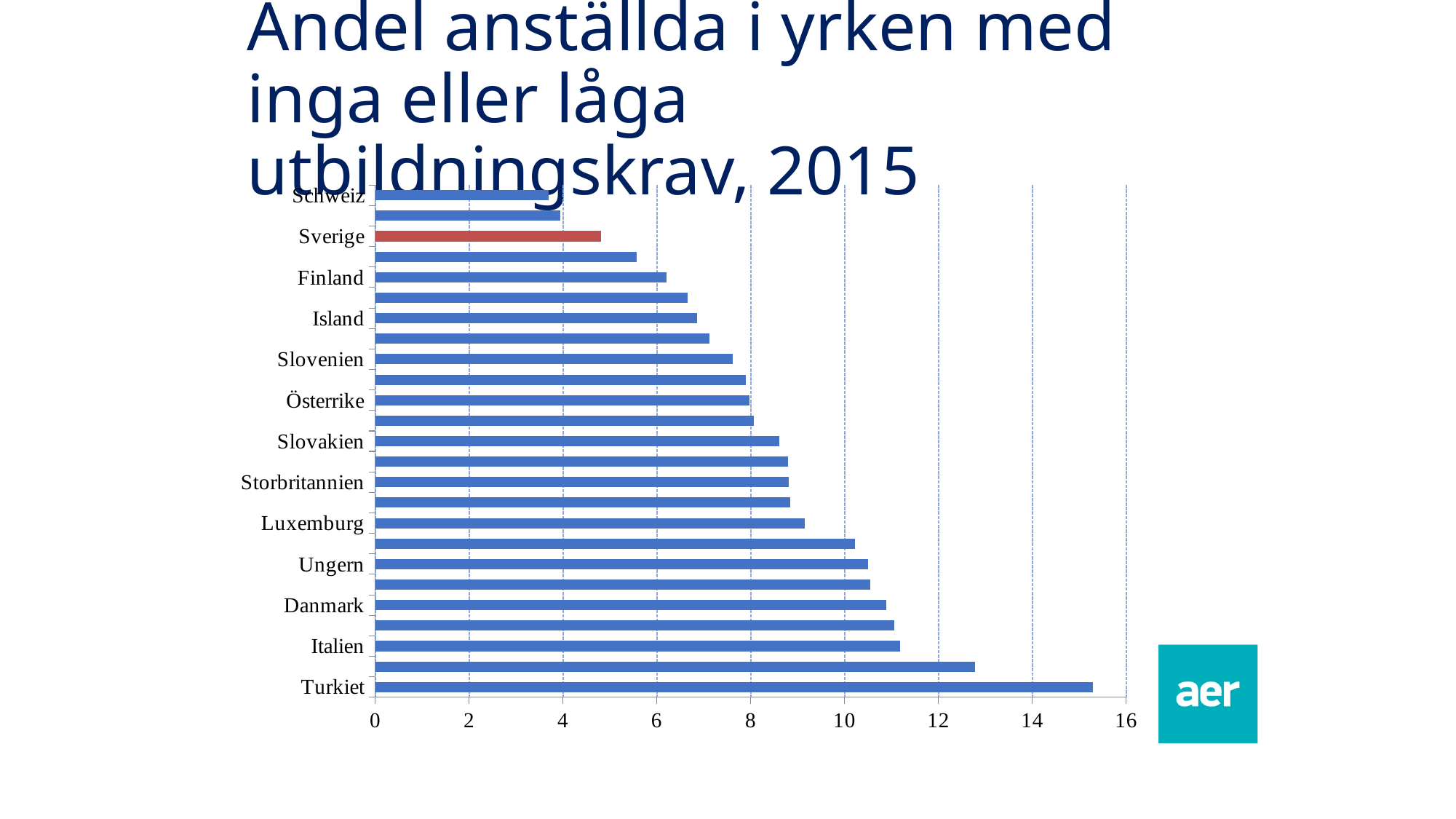
Is the value for Luxemburg greater or less than 10? less Is the value for Sverige greater or less than 6? less Which country's bar is drawn in a different colour (red) from the others? Sverige What is the highest value shown on the horizontal axis? 16 Do the bar values increase or decrease going from the top of the chart to the bottom? increase Which has the larger value, Italien or Finland? Italien What kind of chart is shown on the slide? bar chart Is the value for Italien greater or less than 12? less Which country has the highest value in the chart? Turkiet Which has the larger value, Turkiet or Sverige? Turkiet